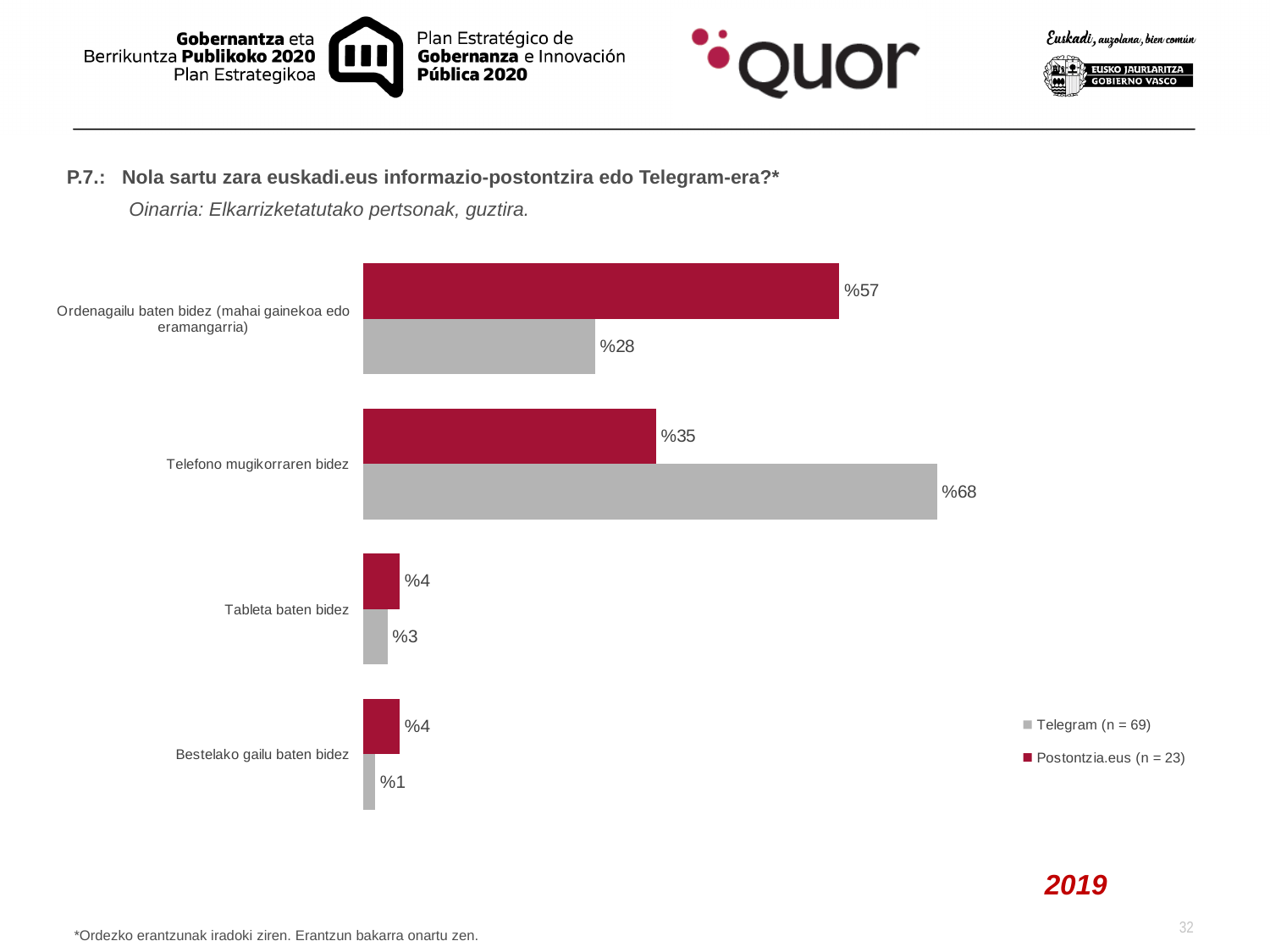
Which category has the highest Telegram value? Telefono mugikorraren bidez Which category has the lowest Telegram value? Bestelako gailu baten bidez What is the Telegram value for "Ordenagailu baten bidez (mahai gainekoa edo eramangarria)"? %28 What is the Postontzia.eus value for "Ordenagailu baten bidez (mahai gainekoa edo eramangarria)"? %57 What is the difference between the Telegram and Postontzia.eus values for "Telefono mugikorraren bidez"? %33 What kind of chart is shown on the slide? Bar chart How many series does the legend list? 2 What is the sample size (n) shown in the legend for Telegram? 69 How many categories are shown in the chart? 4 What is the Telegram value for "Telefono mugikorraren bidez"? %68 What is the Postontzia.eus value for "Bestelako gailu baten bidez"? %4 For "Tableta baten bidez", which series has the larger value, Telegram or Postontzia.eus? Postontzia.eus